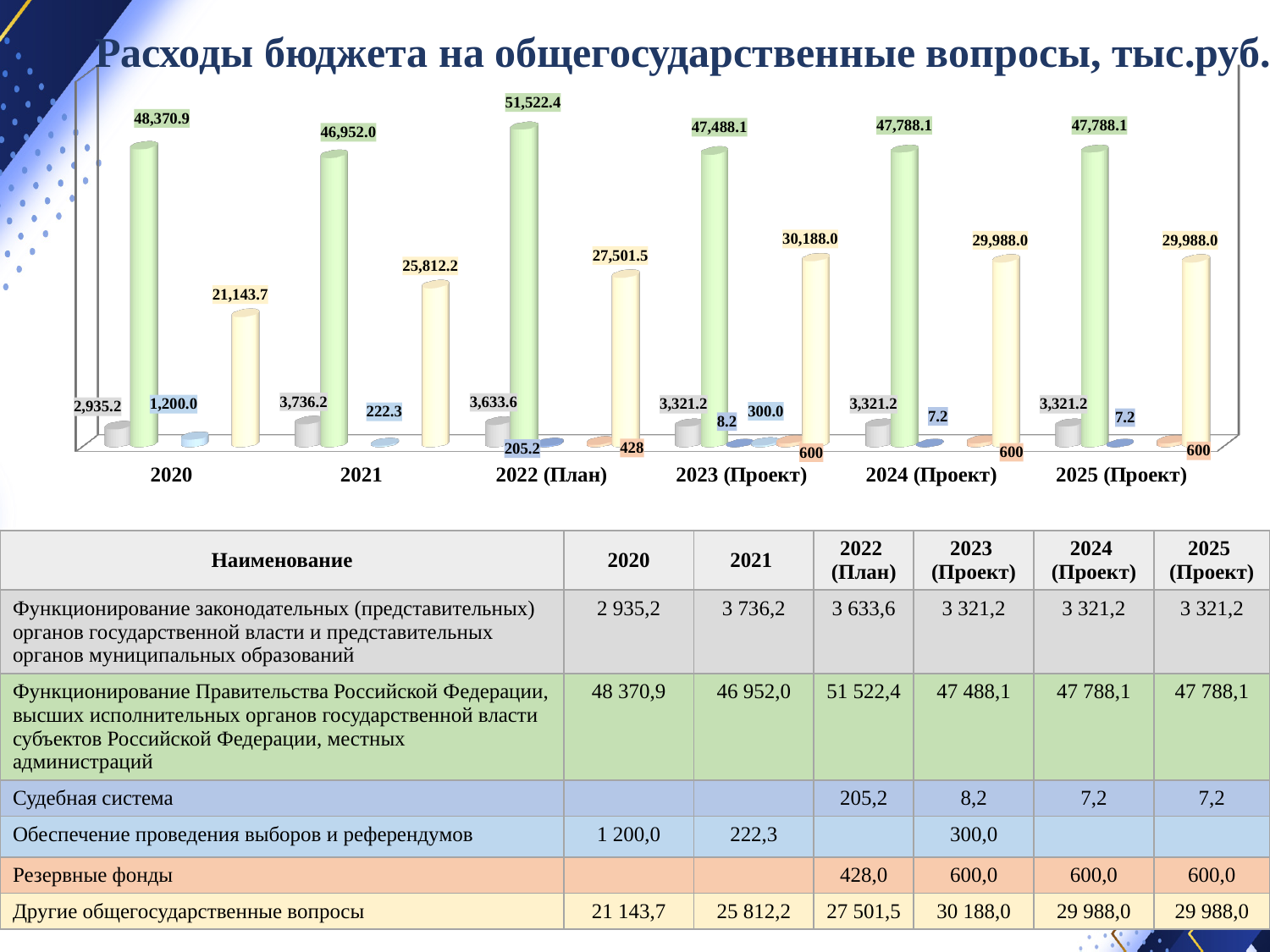
What type of chart is shown on the slide? bar chart What is the value of the yellow bar (Другие общегосударственные вопросы) for 2020? 21,143.7 By how much does the green bar for 2022 (План) exceed the green bar for 2021? 4,570.4 How many year categories are shown on the x axis of the chart? 6 Do the yellow bars (Другие общегосударственные вопросы) rise or fall from 2020 to 2023 (Проект)? rise In which year does the green series (Функционирование Правительства Российской Федерации...) reach its highest value? 2022 (План) What is the value of the orange bar (Резервные фонды) for 2022 (План)? 428 What is the title of the chart? Расходы бюджета на общегосударственные вопросы, тыс.руб. What is the difference between the yellow bar for 2023 (Проект) and the yellow bar for 2022 (План)? 2,686.5 Which is larger: the yellow bar (Другие общегосударственные вопросы) for 2023 (Проект) or for 2024 (Проект)? 2023 (Проект) In which year is the yellow bar (Другие общегосударственные вопросы) the lowest? 2020 What is the value of the green bar (Функционирование Правительства Российской Федерации...) for 2022 (План)? 51,522.4